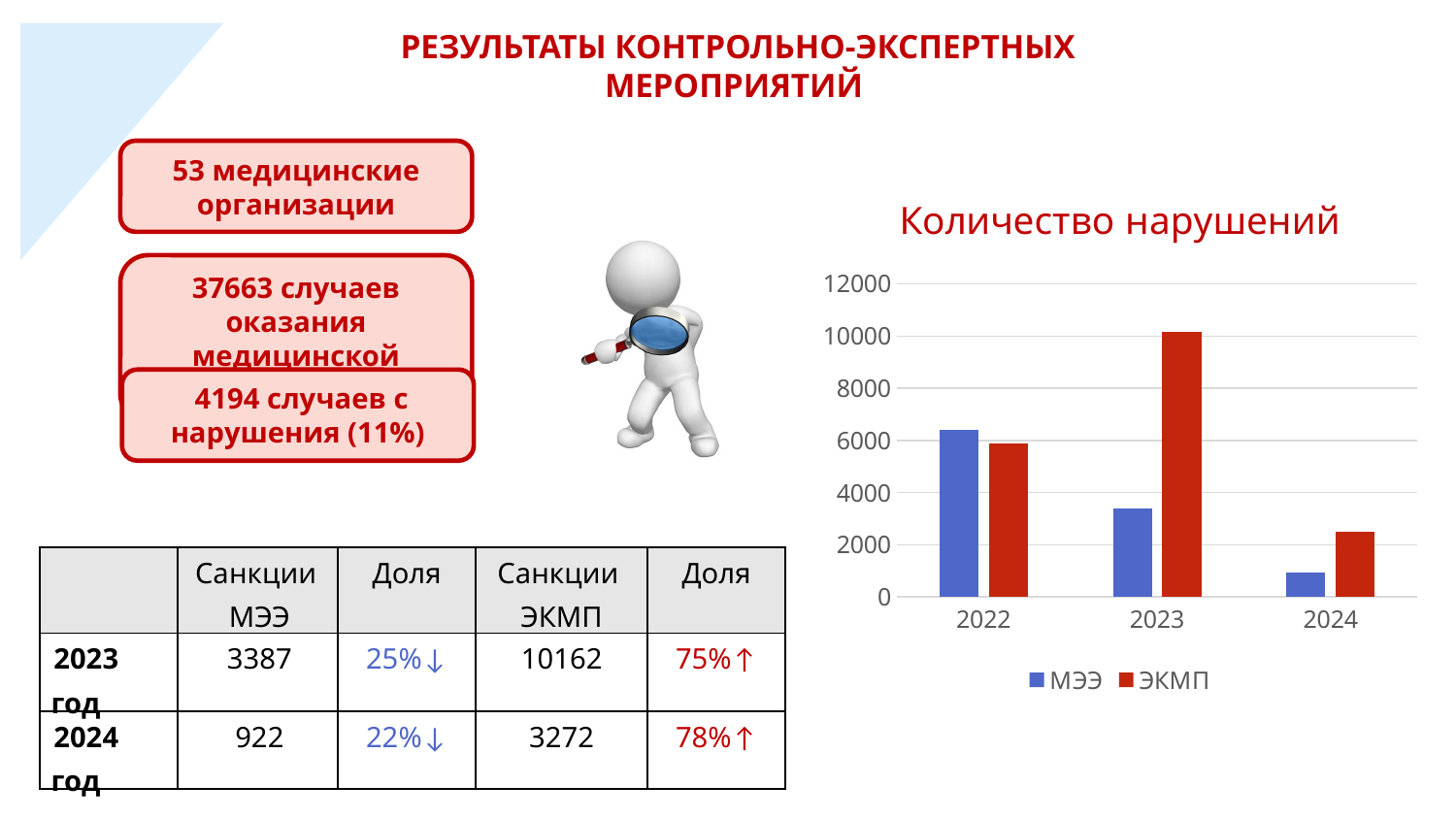
What kind of chart is shown on the slide? bar chart In which year is the ЭКМП value highest? 2023 How many years are shown on the x axis of the chart? 3 Is the ЭКМП value for 2023 greater or less than 8000? greater In 2022, which series has the larger value, МЭЭ or ЭКМП? МЭЭ In which year is the МЭЭ value highest? 2022 In 2023, which series has the larger value, МЭЭ or ЭКМП? ЭКМП In which year is the МЭЭ value lowest? 2024 Does the МЭЭ series rise or fall from 2022 to 2024? fall How many series does the chart legend list? 2 Is the МЭЭ value for 2024 greater or less than 2000? less What is the title of the chart? Количество нарушений